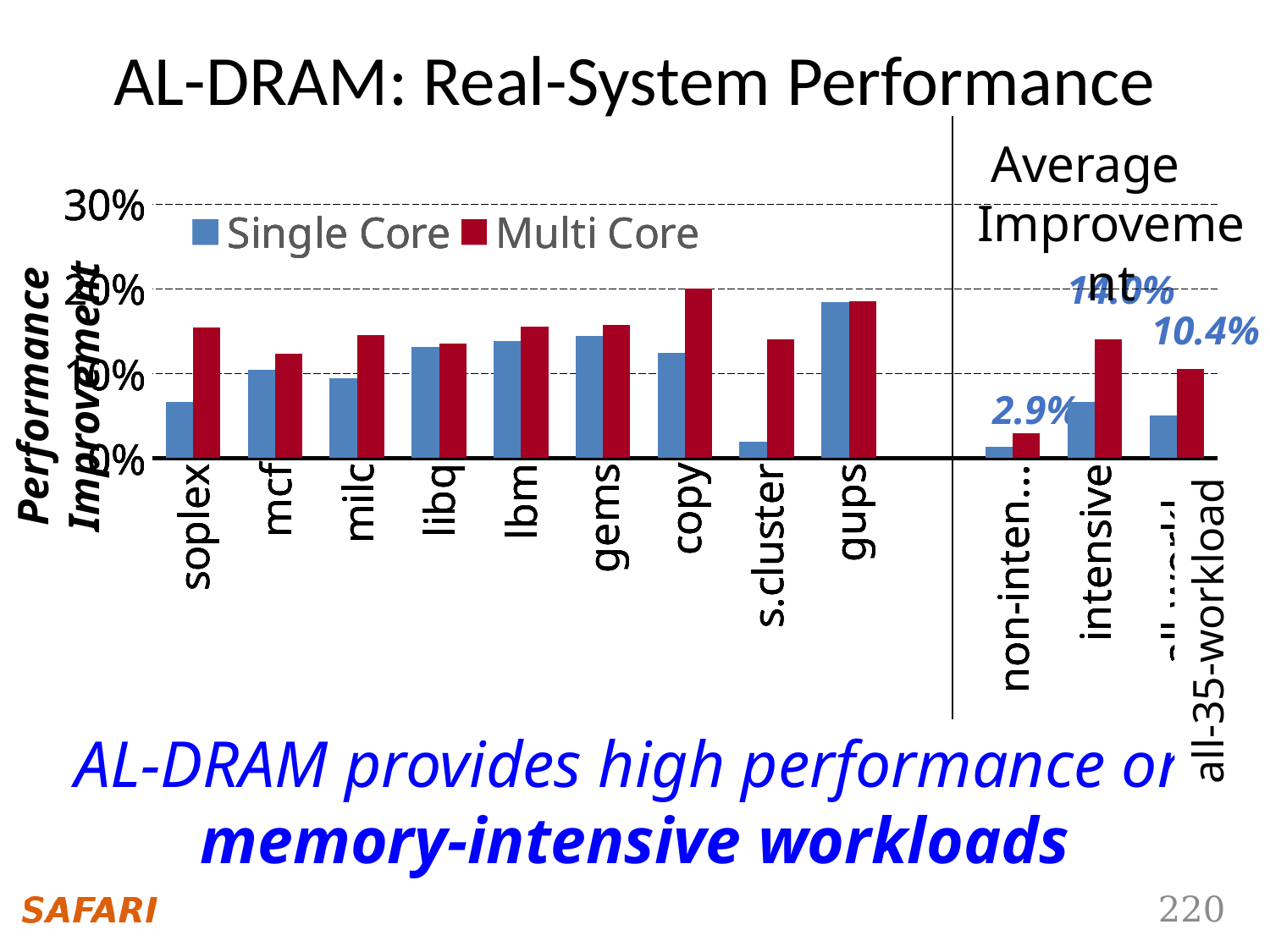
For soplex, which is larger: the Single Core or the Multi Core performance improvement? Multi Core Is the Multi Core value for copy greater or less than 10%? greater Among the nine workloads to the left of the vertical divider, which has the lowest Single Core performance improvement? s.cluster What average improvement value is annotated above the intensive bars? 14.0% How many workloads are plotted to the left of the vertical divider line? 9 Which workload has the highest Single Core performance improvement? gups Which workload has the highest Multi Core performance improvement? copy Is the Single Core value for gups greater or less than 10%? greater What kind of chart is shown on the slide? bar chart How many series does the legend list? 2 What are the two series named in the legend? Single Core and Multi Core Is the Single Core value for s.cluster greater or less than 10%? less